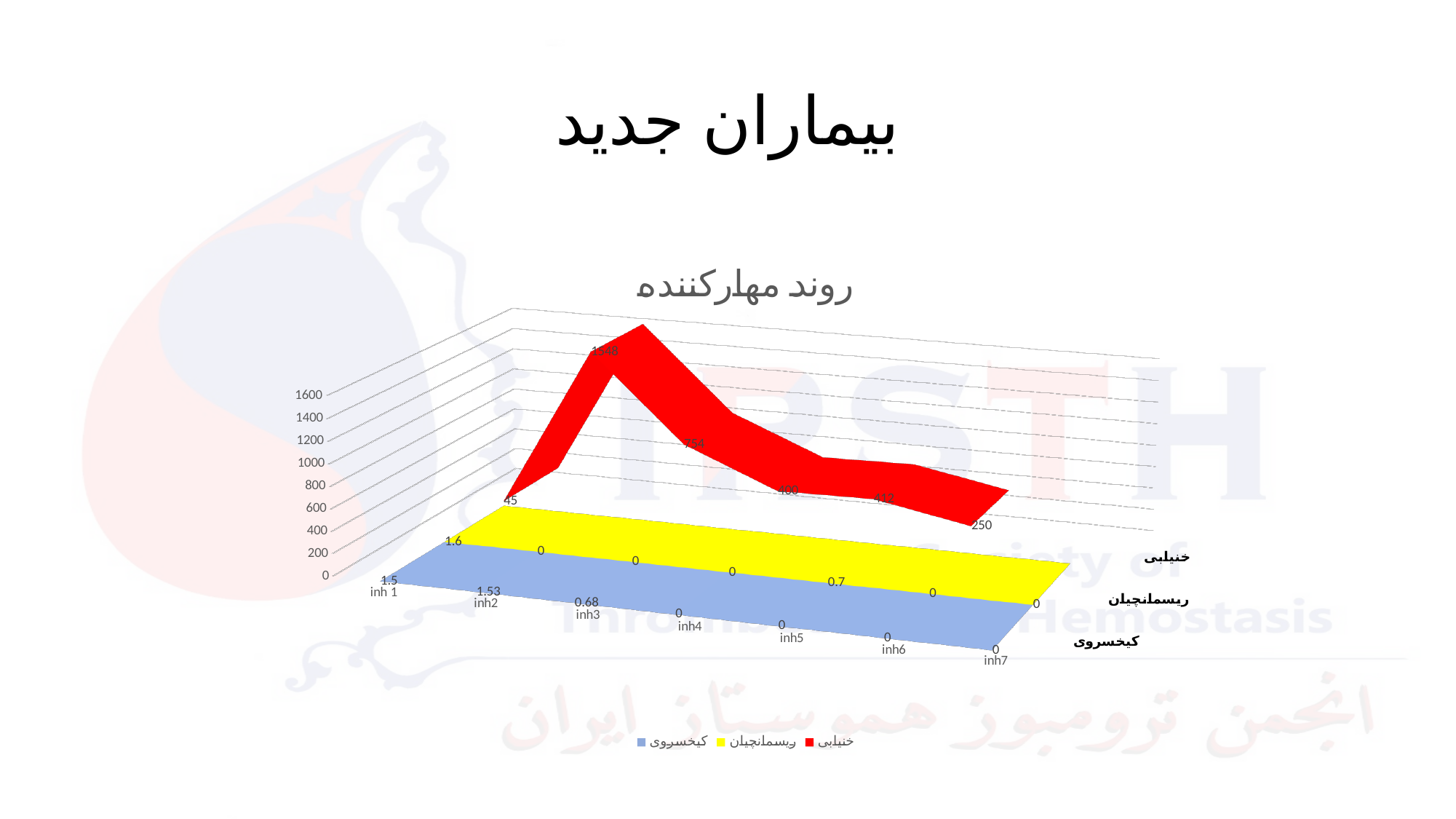
What is the difference between the خنیلبی values at inh2 and inh 1? 1503 What is the value of the ریسمانچیان series at inh 1? 1.6 What is the title of the chart? روند مهارکننده How many series does the legend list? 3 What is the value of the خنیلبی series at inh2? 1548 How many categories are shown on the x axis? 7 For which category does the خنیلبی series reach its highest value? inh2 What kind of chart is shown on the slide? 3D line chart What is the value of the ریسمانچیان series at inh5? 0.7 What is the value of the خنیلبی series at inh 1? 45 Is the value of the خنیلبی series at inh2 greater or less than 1400? greater What is the value of the کیخسروی series at inh3? 0.68